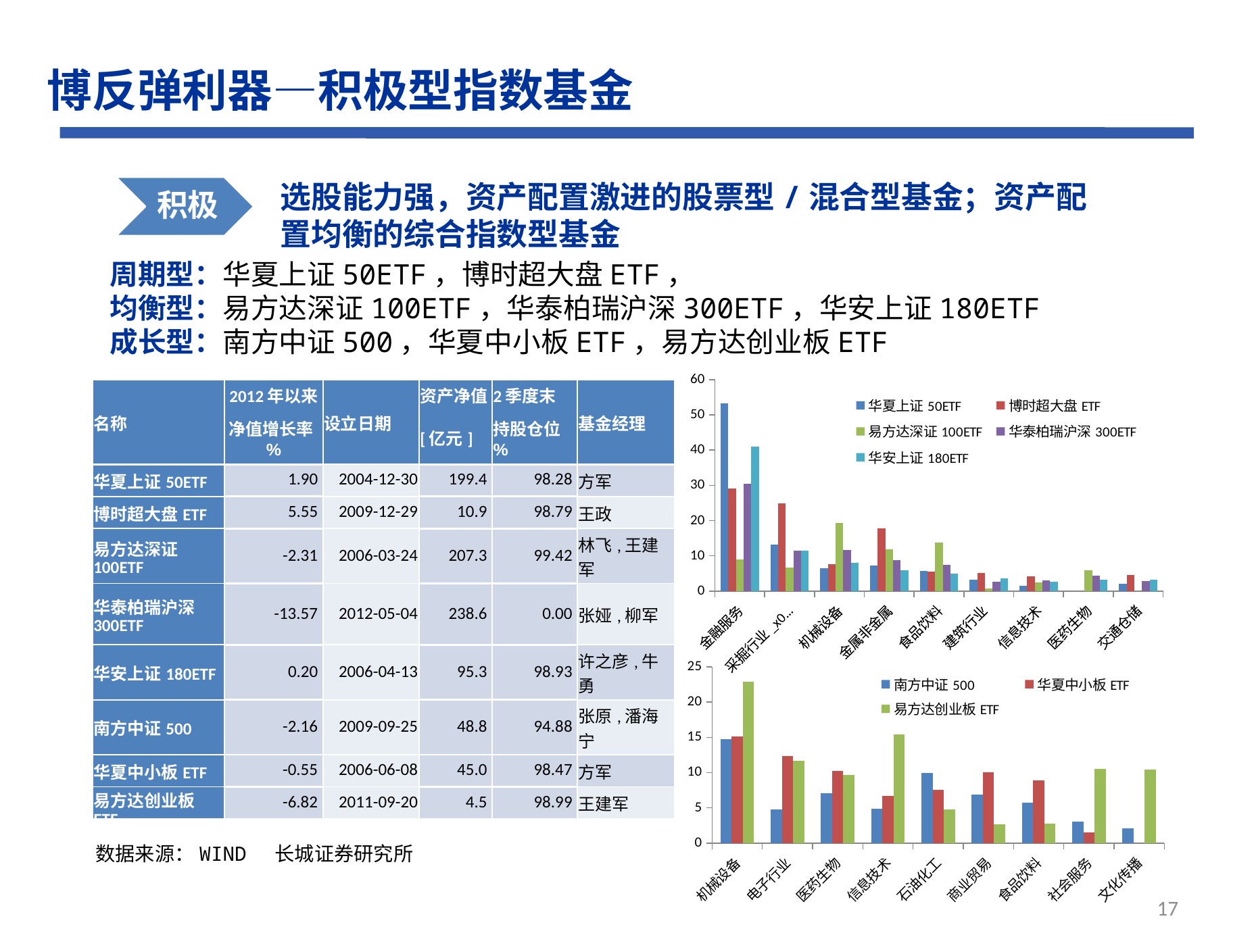
In the top chart, for 金融服务, which is larger: 华夏上证50ETF or 华安上证180ETF? 华夏上证50ETF How many series does the legend of the top chart list? 5 What kind of chart is the bottom chart on the right of the slide? bar chart In the top chart, which category has the highest value for 华夏上证50ETF? 金融服务 How many series does the legend of the bottom chart list? 3 In the bottom chart, for 信息技术, which is larger: 南方中证500 or 易方达创业板ETF? 易方达创业板ETF In the top chart, is the value for 华夏上证50ETF in 金融服务 greater or less than 50? greater How many industry categories are shown on the x axis of the top chart? 9 In the top chart, is the value for 博时超大盘ETF in 金融服务 greater or less than 20? greater What kind of chart is the top chart on the right of the slide? bar chart In the bottom chart, which category has the highest value for 易方达创业板ETF? 机械设备 In the bottom chart, is the value for 易方达创业板ETF in 机械设备 greater or less than 20? greater